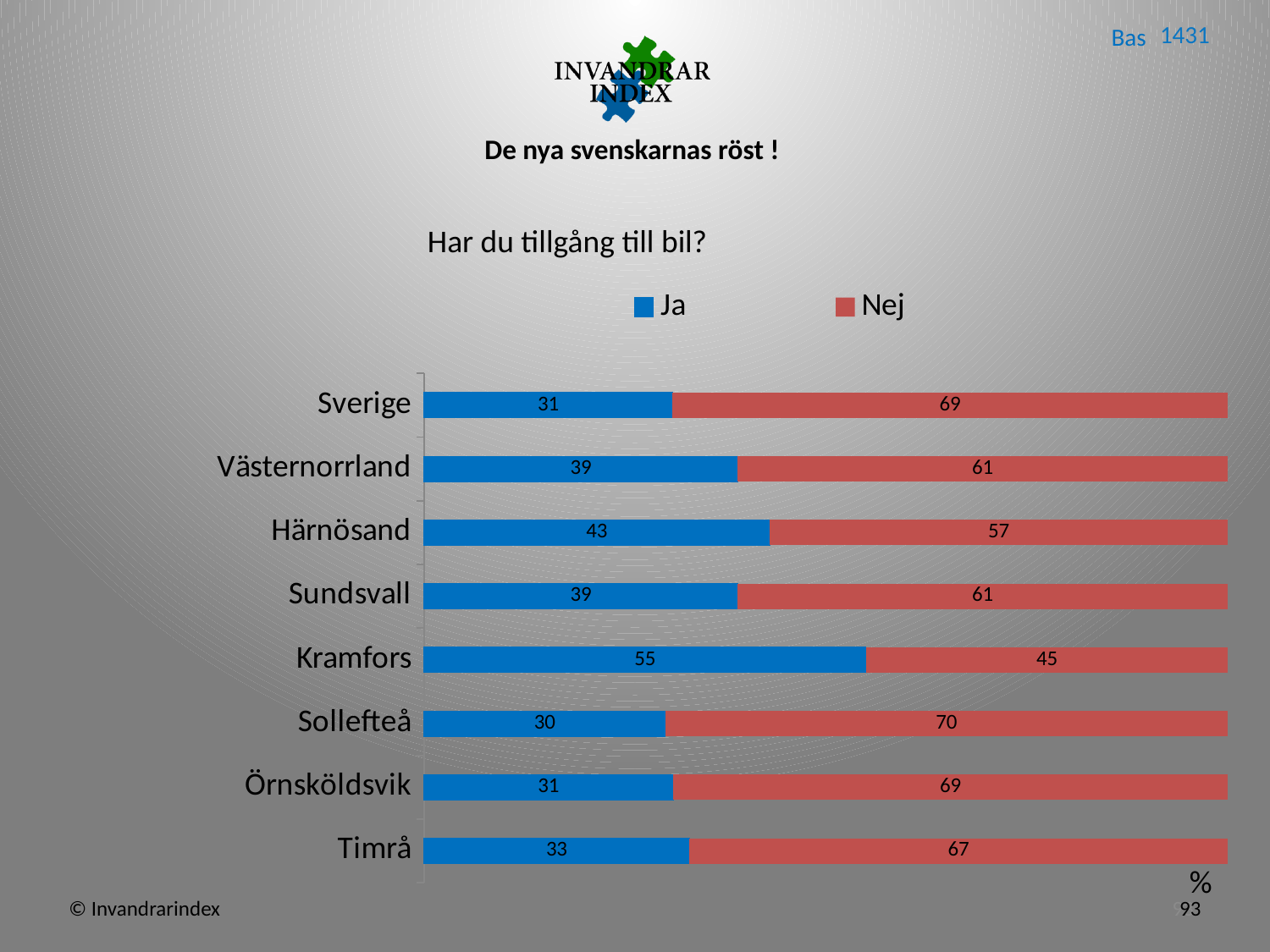
Which category has the highest "Ja" value? Kramfors Which is larger, the "Ja" value for Härnösand or the "Ja" value for Timrå? Härnösand What is the value for "Ja" for Kramfors? 55 What is the question shown as the chart title? Har du tillgång till bil? How many series does the legend list? 2 What is the total of the stacked bar for Västernorrland? 100 What is the difference between the "Nej" values for Sverige and Kramfors? 24 What is the value for "Nej" for Sollefteå? 70 What kind of chart is shown on the slide? Stacked bar chart How many categories are shown on the chart? 8 What is the value for "Ja" for Härnösand? 43 Which category has the lowest "Ja" value? Sollefteå